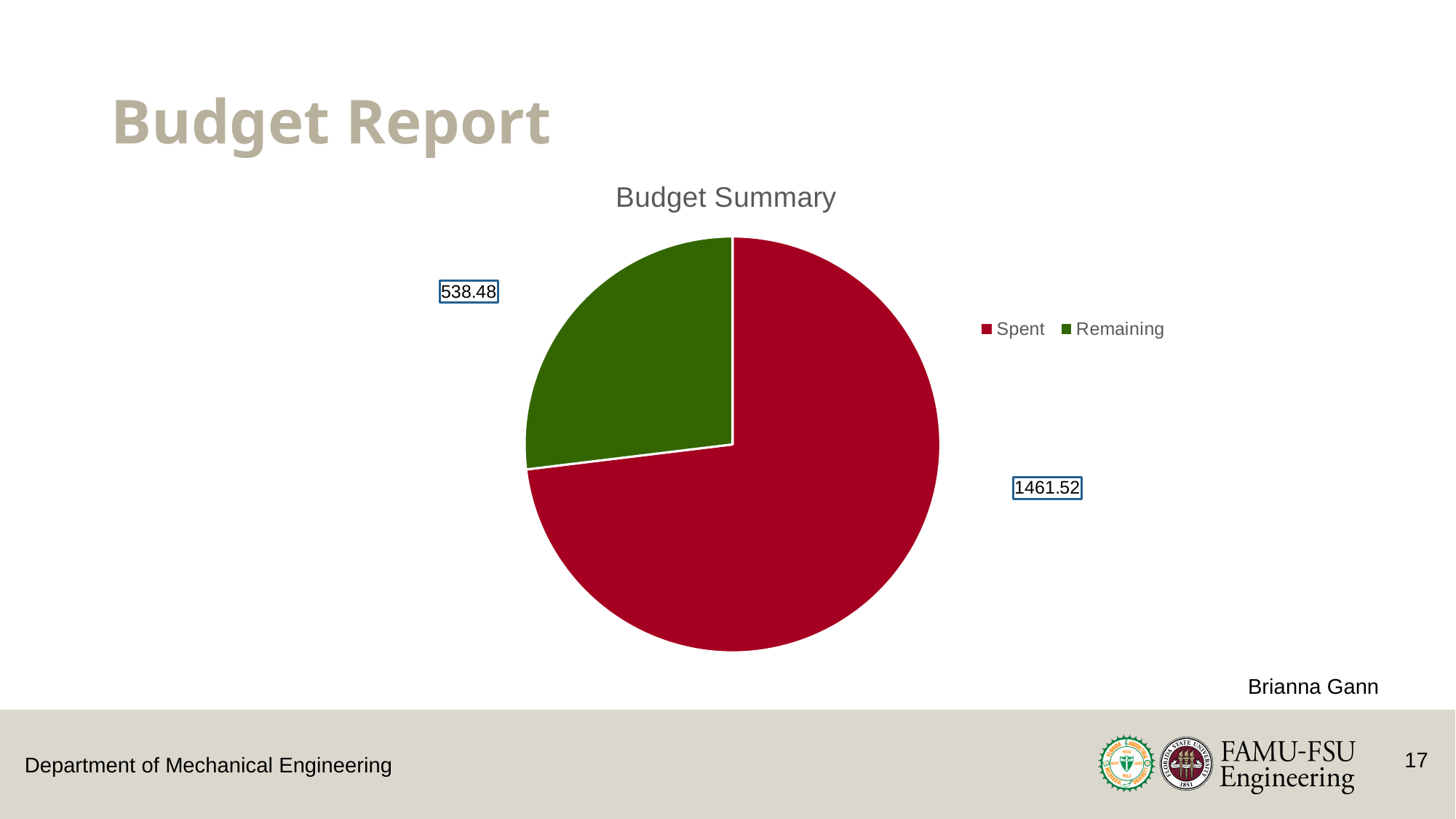
What is the difference between the Spent and Remaining values? 923.04 How many slices does the pie chart have? 2 What is the title of the chart? Budget Summary Which slice is the smallest? Remaining What colour is the Remaining slice? green What is the value of the Spent slice? 1461.52 Which is larger, Spent or Remaining? Spent Which slice is the largest? Spent How many entries does the legend list? 2 What kind of chart is shown on the slide? pie chart What is the total of the two slices in the pie? 2000.00 What is the value of the Remaining slice? 538.48